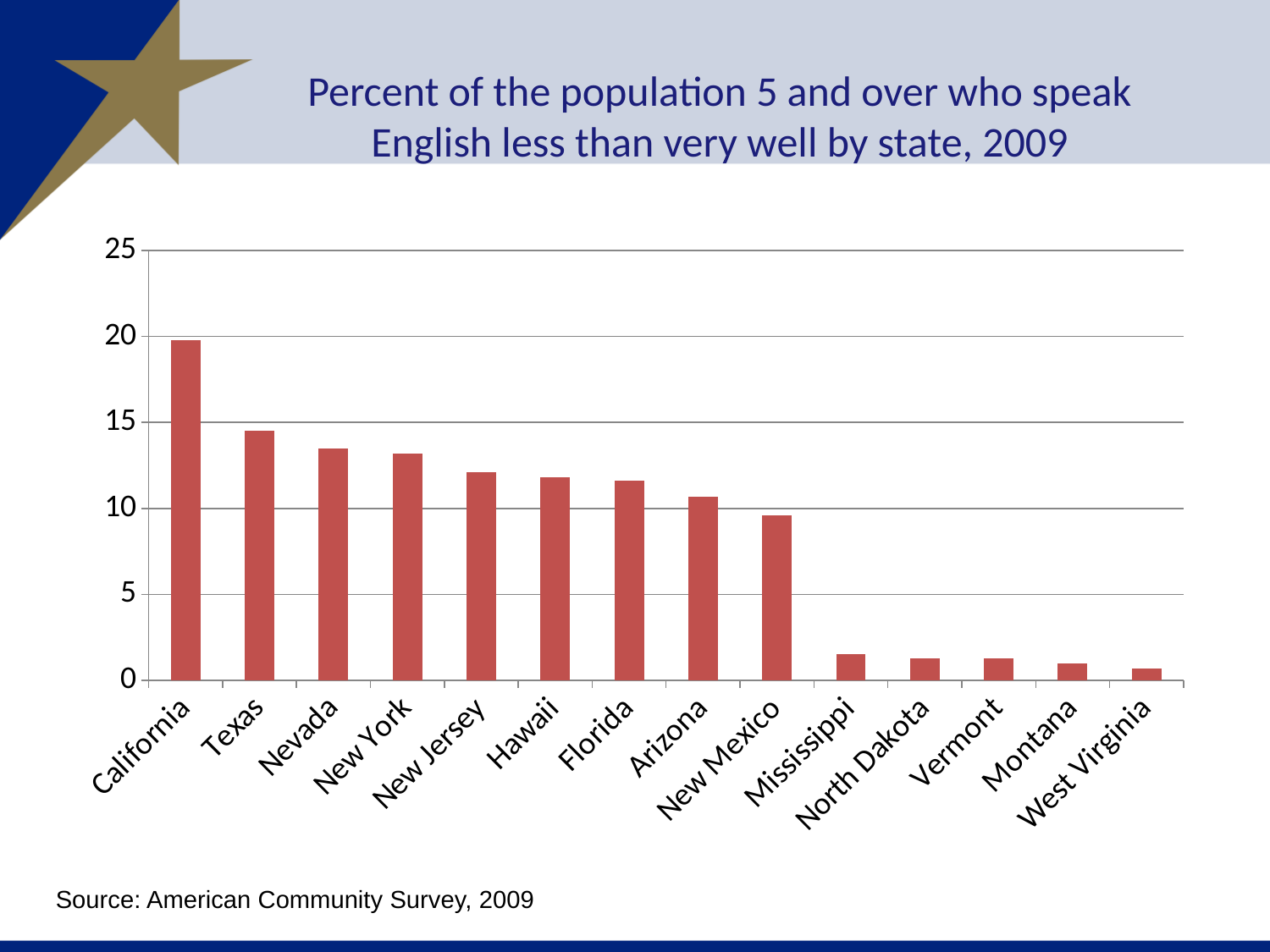
Is the value for California greater or less than 15? greater Is the value for Arizona greater or less than 10? greater How many states are shown on the chart? 14 What kind of chart is shown on the slide? bar chart Is the value for New Mexico greater or less than 10? less Which state has the highest percent of the population 5 and over who speak English less than very well? California What source is cited for the chart data? American Community Survey, 2009 Do the values rise or fall moving from left to right along the x axis? fall Which has a higher value, Texas or Nevada? Texas Which state has the lowest percent of the population 5 and over who speak English less than very well? West Virginia